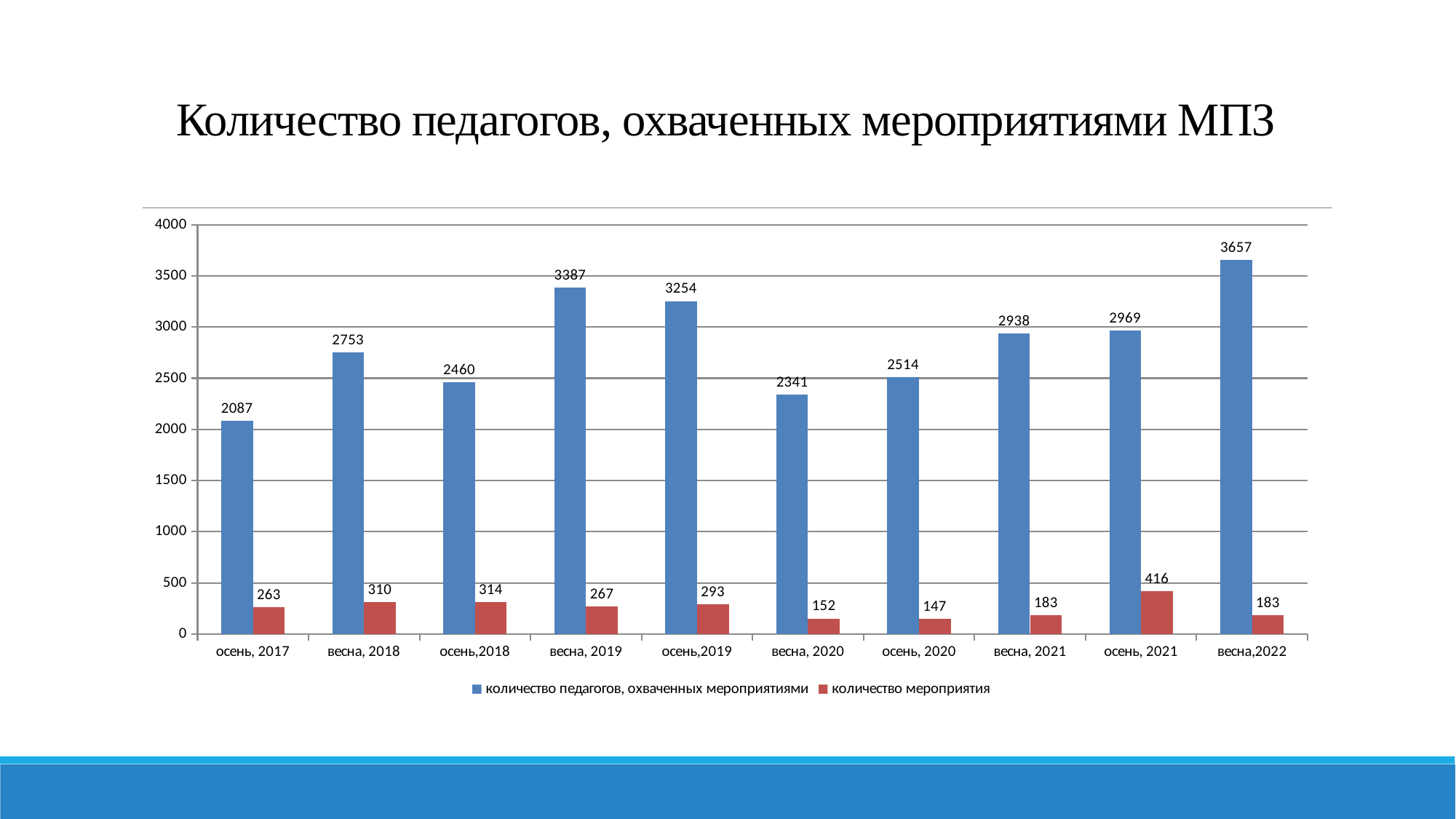
How many periods are shown on the x axis? 10 What is the value of "количество педагогов, охваченных мероприятиями" for весна, 2019? 3387 What is the value of "количество мероприятия" for осень, 2021? 416 Which period has the lowest value for "количество мероприятия"? осень, 2020 What is the value of "количество педагогов, охваченных мероприятиями" for осень, 2017? 2087 Which period has the highest value for "количество педагогов, охваченных мероприятиями"? весна,2022 Which is larger: the "количество мероприятия" value for весна, 2018 or for осень,2018? осень,2018 What is the title of the slide? Количество педагогов, охваченных мероприятиями МПЗ How many series does the legend list? 2 What kind of chart is shown on the slide? bar chart Is the value of "количество педагогов, охваченных мероприятиями" for весна, 2020 greater or less than 2500? less What is the difference between the "количество педагогов, охваченных мероприятиями" values for весна,2022 and осень, 2017? 1570